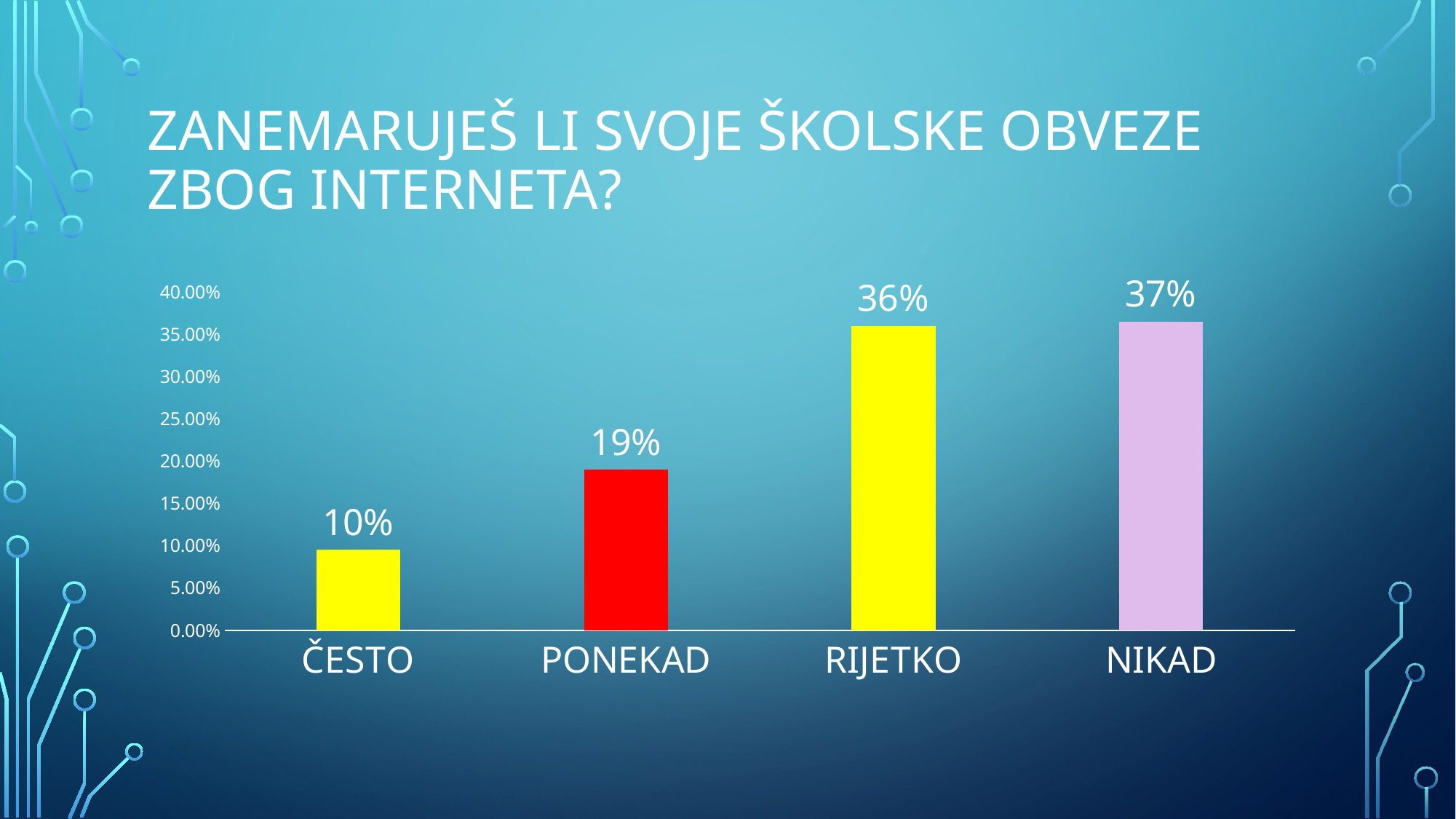
What colour is the bar for PONEKAD? red What is the value for RIJETKO? 36% Is the value for PONEKAD greater or less than 20.00%? less Which is larger, the value for PONEKAD or the value for ČESTO? PONEKAD Which category has the lowest value? ČESTO Which category has the highest value? NIKAD What is the value for PONEKAD? 19% What is the value for NIKAD? 37% What is the difference between the values for RIJETKO and PONEKAD? 17% How many categories are shown on the x axis? 4 What kind of chart is shown on the slide? bar chart What is the value for ČESTO? 10%